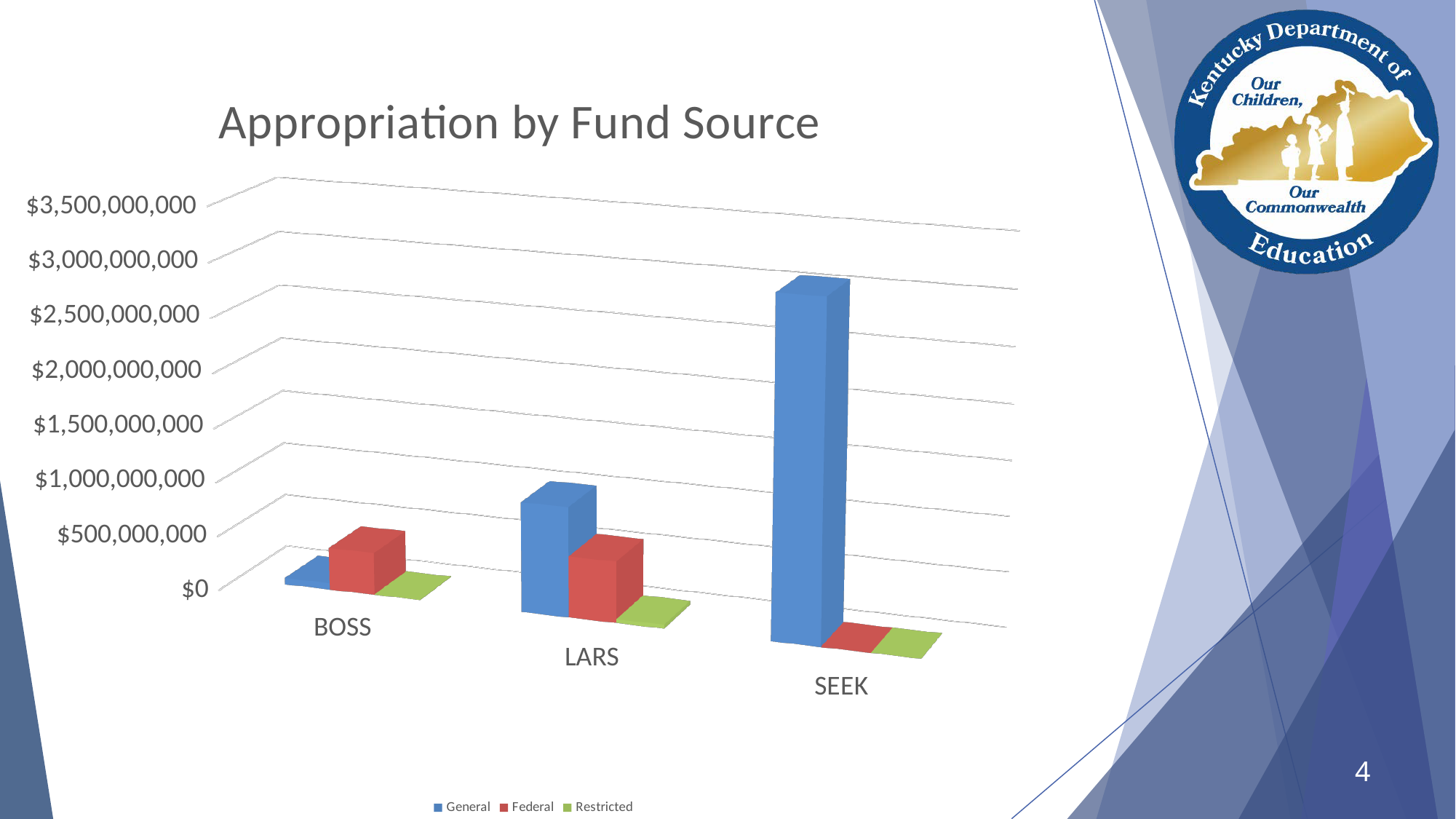
Which category has the highest General appropriation? SEEK What is the title of the chart? Appropriation by Fund Source Is the General value for BOSS greater or less than $500,000,000? less Is the General value for LARS greater or less than $500,000,000? greater Which category has the lowest General appropriation? BOSS Is the General value for SEEK greater or less than $2,000,000,000? greater Which series is shown in blue in the chart? General For BOSS, which is larger: the General value or the Federal value? Federal For LARS, which is larger: the General value or the Federal value? General What kind of chart is shown on the slide? bar chart How many series does the chart's legend list? 3 How many categories are shown on the x axis of the chart? 3